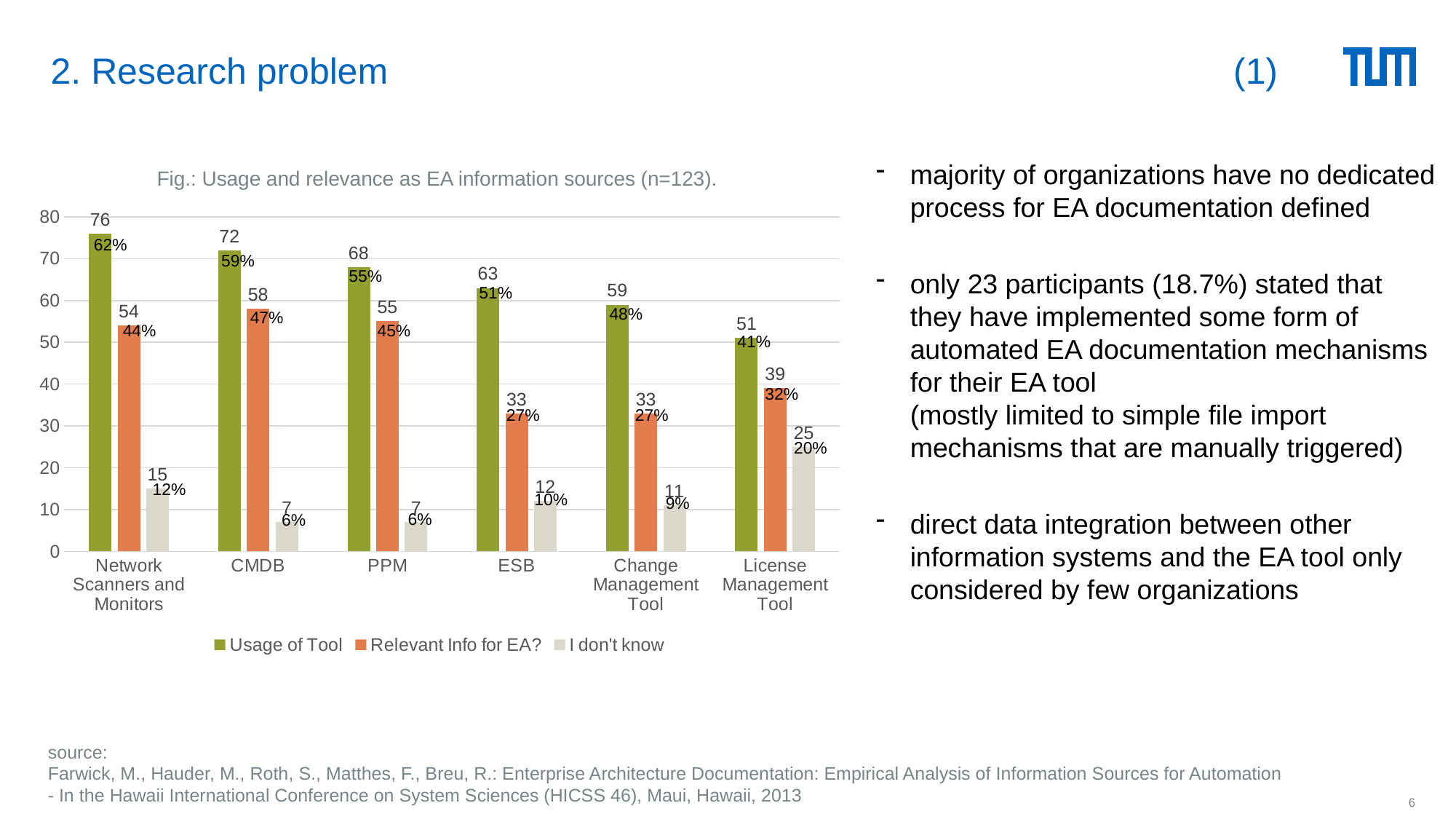
Is the Usage of Tool value for Change Management Tool greater or less than 50? greater What is the difference between the Usage of Tool values for Network Scanners and Monitors and License Management Tool? 25 How many series does the legend list? 3 What is the I don't know value for License Management Tool? 25 Which is larger: the Relevant Info for EA? value for PPM or for License Management Tool? PPM What is the Usage of Tool value for CMDB? 72 Which category has the lowest Relevant Info for EA? value? ESB and Change Management Tool (33 each) What is the Relevant Info for EA? value for ESB? 33 Which category has the highest Usage of Tool value? Network Scanners and Monitors How many categories are shown on the x axis? 6 What is the title of the chart? Fig.: Usage and relevance as EA information sources (n=123). What kind of chart is shown on the slide? Bar chart